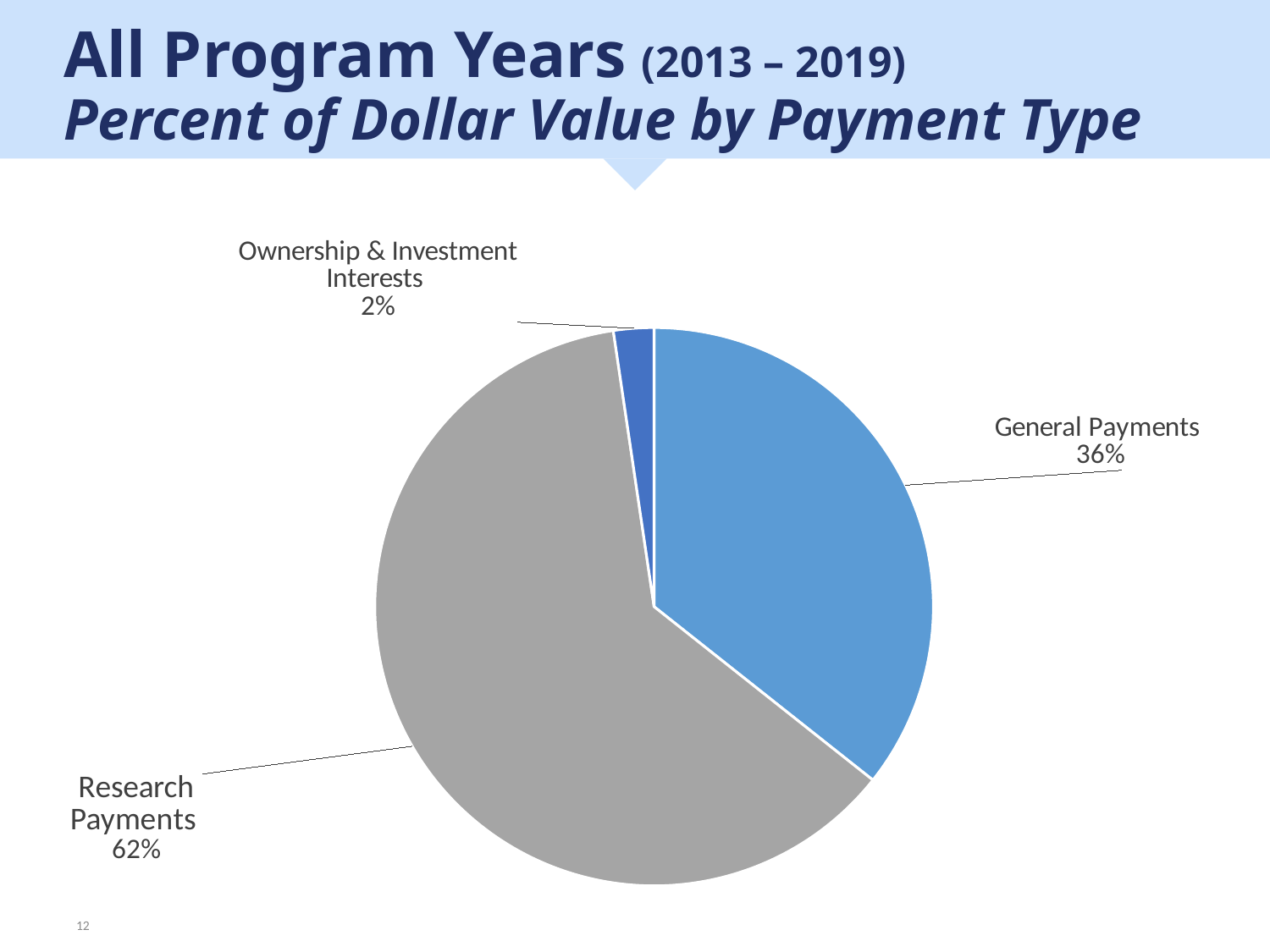
What percent of dollar value is attributed to General Payments? 36% How many payment types are shown in the pie chart? 3 What range of program years does the chart title cover? 2013 – 2019 What percent of dollar value is attributed to Research Payments? 62% What share of the pie does the Research Payments slice represent? 62% Which payment type has the smallest share of dollar value? Ownership & Investment Interests What is the combined share of General Payments and Ownership & Investment Interests? 38% Which payment type has the largest share of dollar value? Research Payments What is the difference in percentage points between Research Payments and General Payments? 26 Which is larger: the share for General Payments or the share for Ownership & Investment Interests? General Payments What percent of dollar value is attributed to Ownership & Investment Interests? 2% What type of chart is shown on the slide? Pie chart